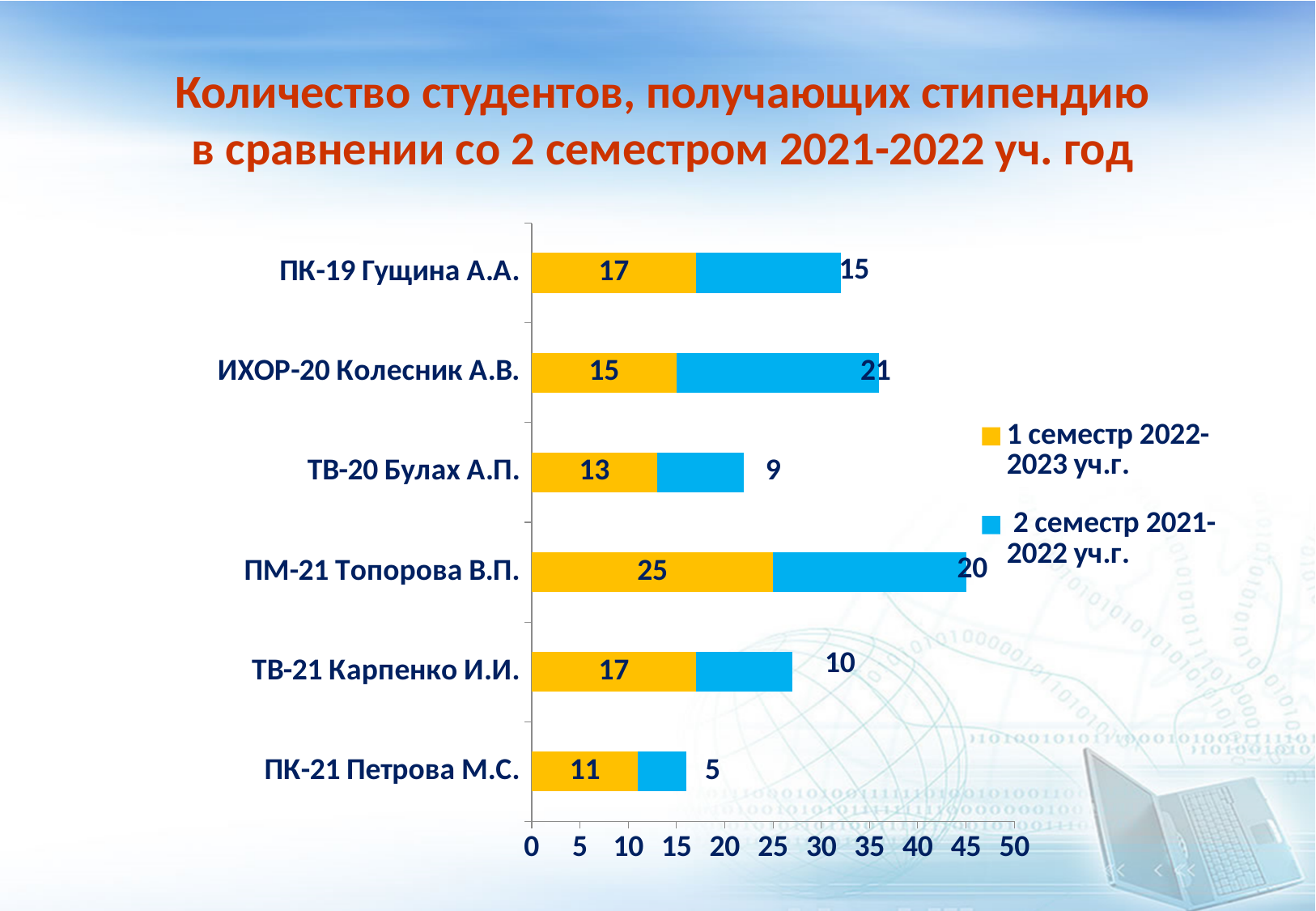
How many series does the legend list? 2 What type of chart is shown on the slide? bar chart For ИХОР-20 Колесник А.В., which series has the larger value: '1 семестр 2022-2023 уч.г.' or '2 семестр 2021-2022 уч.г.'? 2 семестр 2021-2022 уч.г. What is the total of the stacked bar for ПМ-21 Топорова В.П.? 45 Which category has the highest value in the series '1 семестр 2022-2023 уч.г.'? ПМ-21 Топорова В.П. What is the value for ПМ-21 Топорова В.П. in the series '1 семестр 2022-2023 уч.г.'? 25 What is the value for ИХОР-20 Колесник А.В. in the series '2 семестр 2021-2022 уч.г.'? 21 What is the difference between the two series values for ТВ-21 Карпенко И.И.? 7 What is the value for ПК-21 Петрова М.С. in the series '2 семестр 2021-2022 уч.г.'? 5 How many categories (groups/teachers) are shown on the chart? 6 Which colour represents the series '1 семестр 2022-2023 уч.г.' in the chart? yellow Which category has the lowest value in the series '2 семестр 2021-2022 уч.г.'? ПК-21 Петрова М.С.